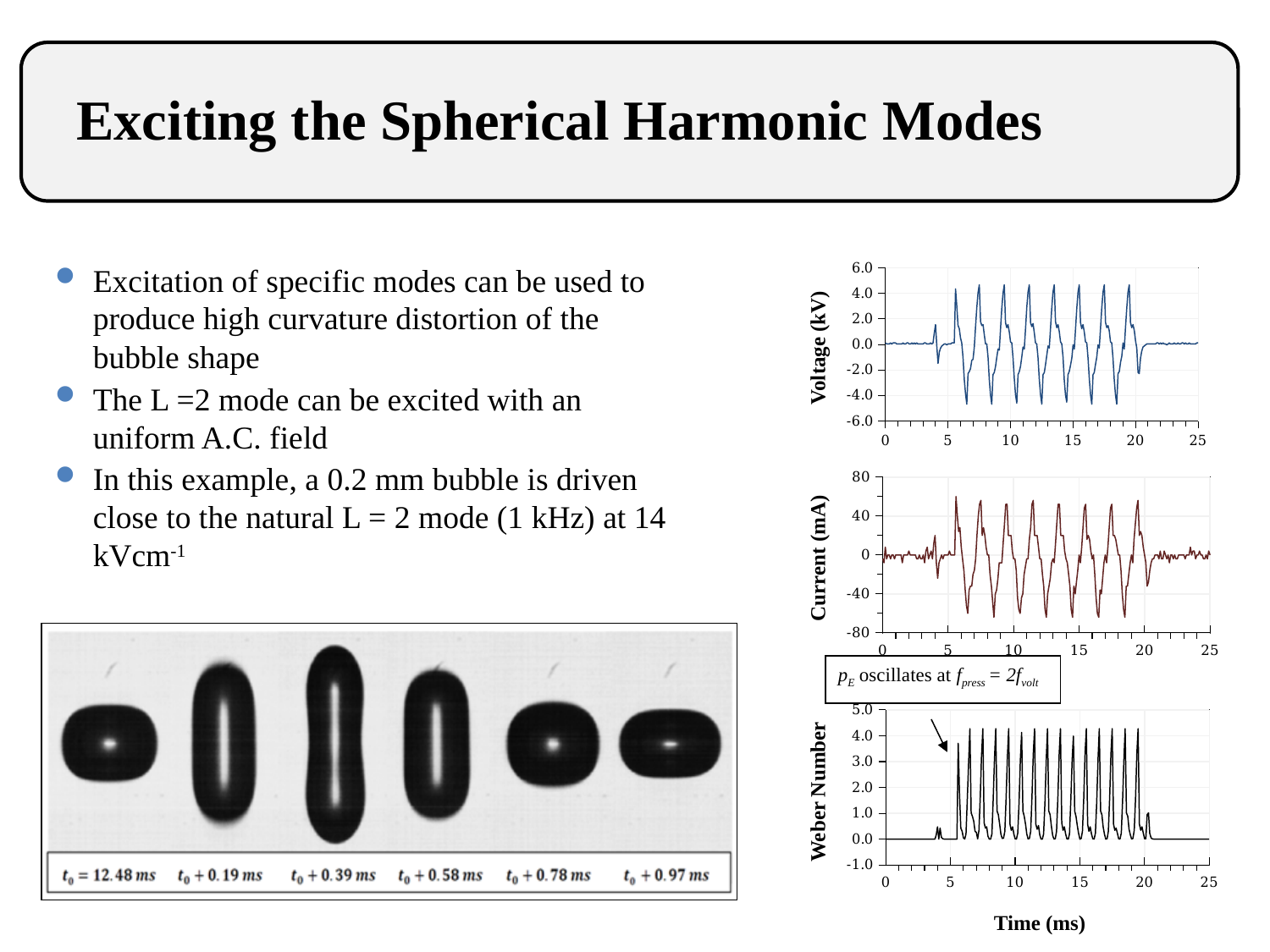
In the Weber Number chart, is the Weber number at time 0 greater or less than 1.0? less In the Current (mA) chart, is the peak current reached during the oscillation greater or less than 80? less In the Voltage (kV) chart, is the voltage at time 0 greater or less than 2.0? less What is the y-axis label of the middle chart? Current (mA) What is the highest value shown on the x axis of the Weber Number chart? 25 What kind of chart is the top chart (Voltage (kV))? line chart How many charts are plotted on the right side of the slide? 3 What is the x-axis label shared by the charts on the right? Time (ms)